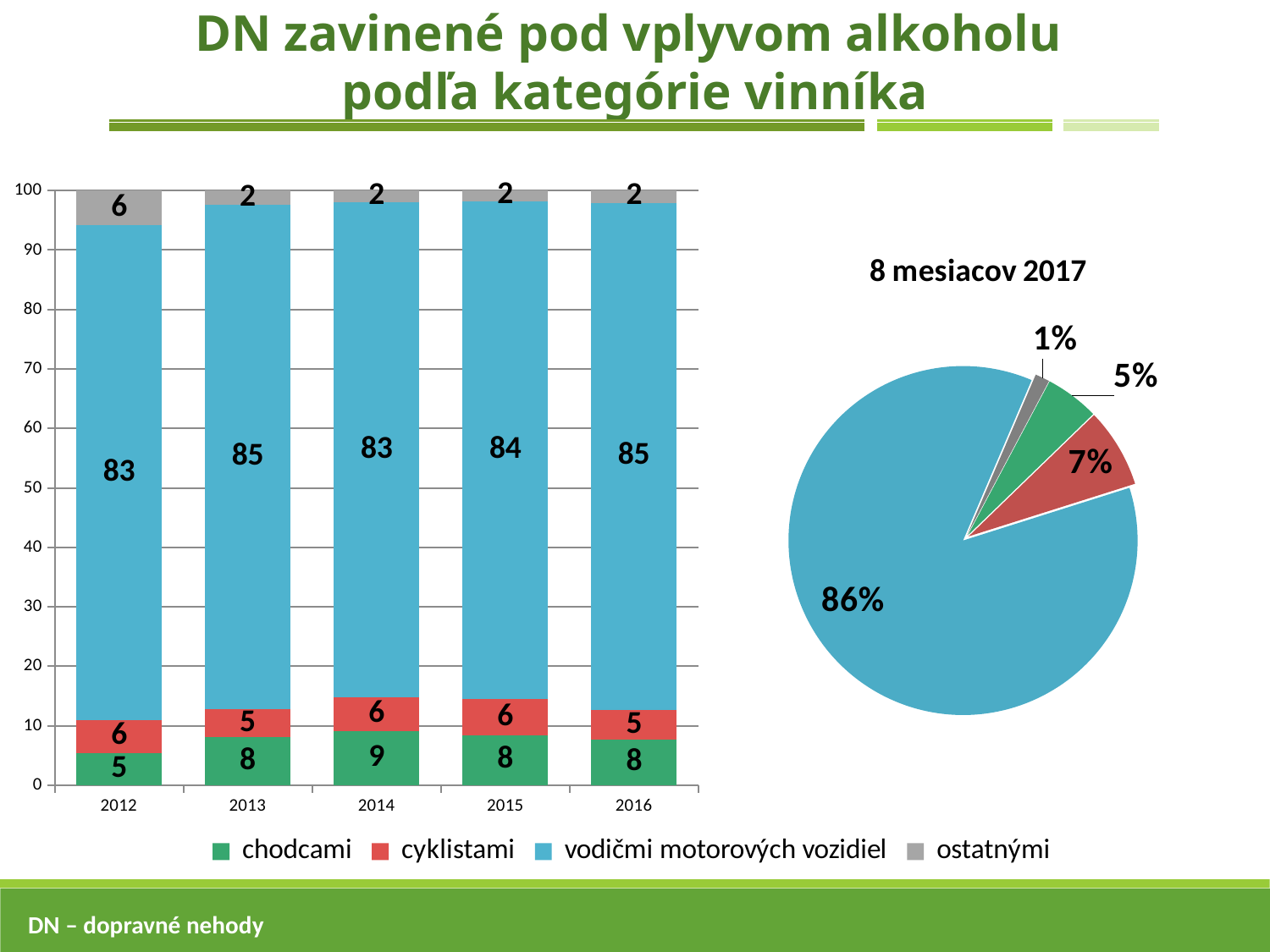
In the stacked bar chart on the left, which year has the highest value for 'chodcami'? 2014 In the stacked bar chart on the left, what is the value for 'vodičmi motorových vozidiel' in 2014? 83 In the pie chart titled '8 mesiacov 2017', what share does the red slice (cyklistami) have? 7% In the pie chart titled '8 mesiacov 2017', what share does the largest slice have? 86% In the stacked bar chart on the left, what is the value for 'chodcami' in 2012? 5 In the stacked bar chart on the left, how many years are shown on the x axis? 5 In the stacked bar chart on the left, what is the difference between the 'ostatnými' values for 2012 and 2013? 4 In the stacked bar chart on the left, is the 'cyklistami' value larger in 2014 or in 2016? 2014 How many series does the legend of the stacked bar chart list? 4 What kind of chart is the chart on the left of the slide? Stacked bar chart In the stacked bar chart on the left, what is the total of the stacked bar for 2015? 100 In the stacked bar chart on the left, what is the value for 'ostatnými' in 2012? 6